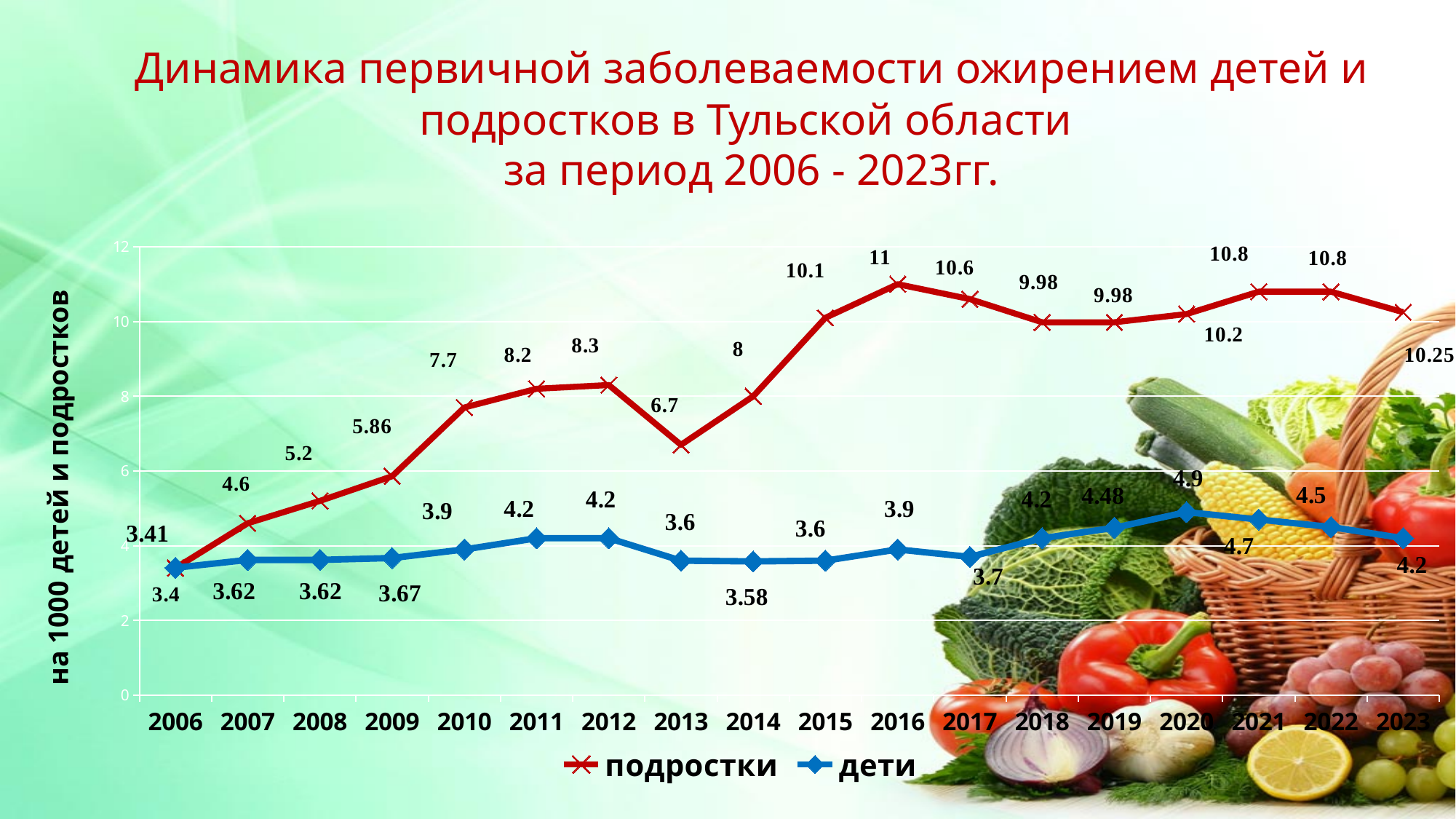
Which series has the larger value in 2010, подростки or дети? подростки In which year is the дети series at its lowest value? 2006 In which year does the подростки series reach its highest value? 2016 Does the подростки series rise or fall from 2006 to 2012? rise What is the value for подростки in 2023? 10.25 What is the value for дети in 2019? 4.48 What is the value for подростки in 2016? 11 In which year does the дети series reach its highest value? 2020 What type of chart is shown on the slide? line chart How many years are plotted along the x axis? 18 What is the difference between the подростки value in 2012 and in 2013? 1.6 How many series does the legend list? 2